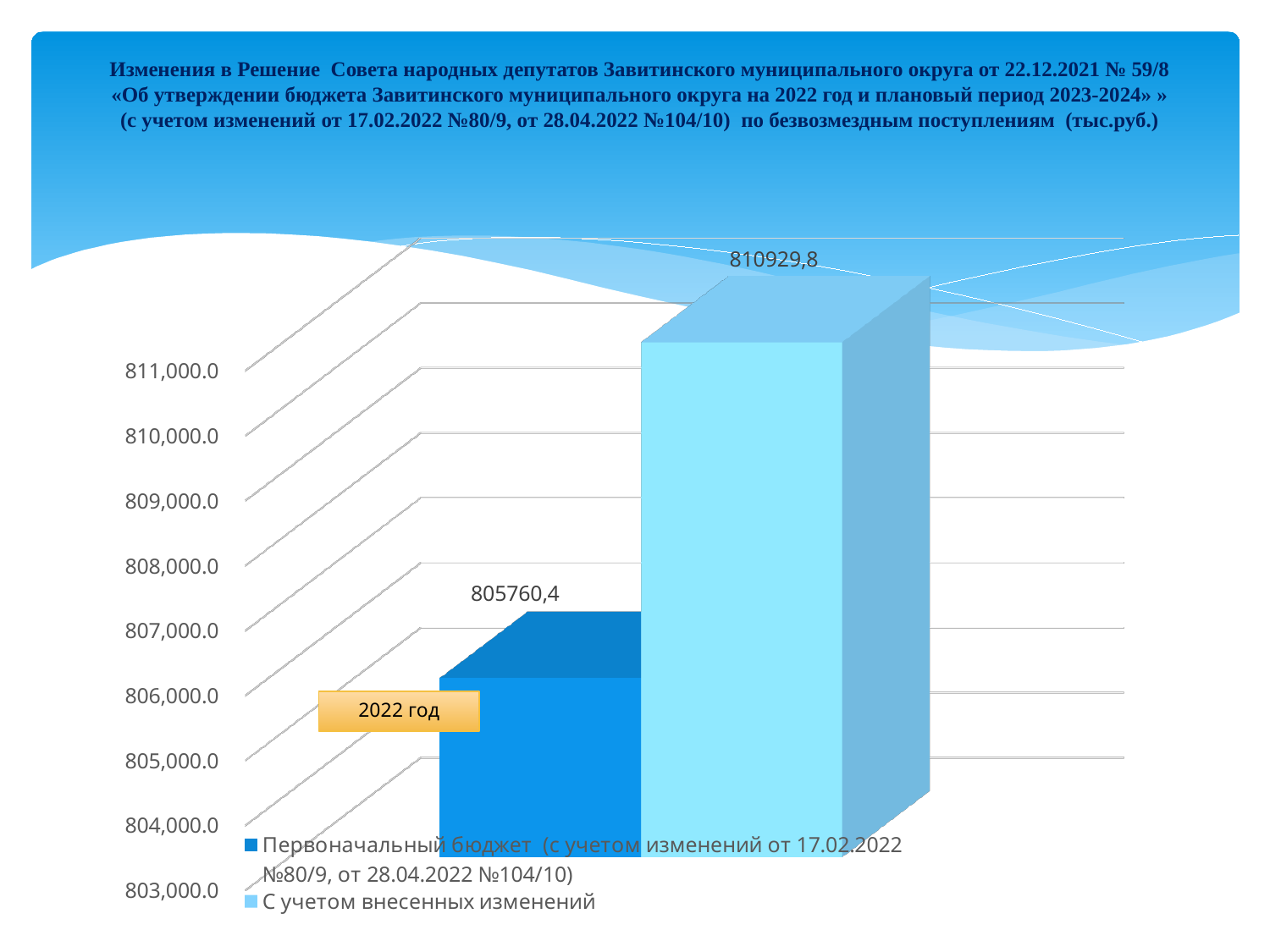
Is the value for "С учетом внесенных изменений" larger or smaller than the value for "Первоначальный бюджет"? larger What is the value for the series "С учетом внесенных изменений"? 810929,8 Which series has the lower value? Первоначальный бюджет (с учетом изменений от 17.02.2022 №80/9, от 28.04.2022 №104/10) Which series has the higher value? С учетом внесенных изменений What category label is shown on the chart? 2022 год What is the difference between the value for "С учетом внесенных изменений" and the value for "Первоначальный бюджет"? 5169,4 What kind of chart is shown on the slide? bar chart Is the value for "Первоначальный бюджет" greater or less than 807,000.0? less What is the value for the series "Первоначальный бюджет (с учетом изменений от 17.02.2022 №80/9, от 28.04.2022 №104/10)"? 805760,4 Is the value for "С учетом внесенных изменений" greater or less than 810,000.0? greater What unit of measurement is stated in the chart title? тыс.руб. How many series does the legend list? 2